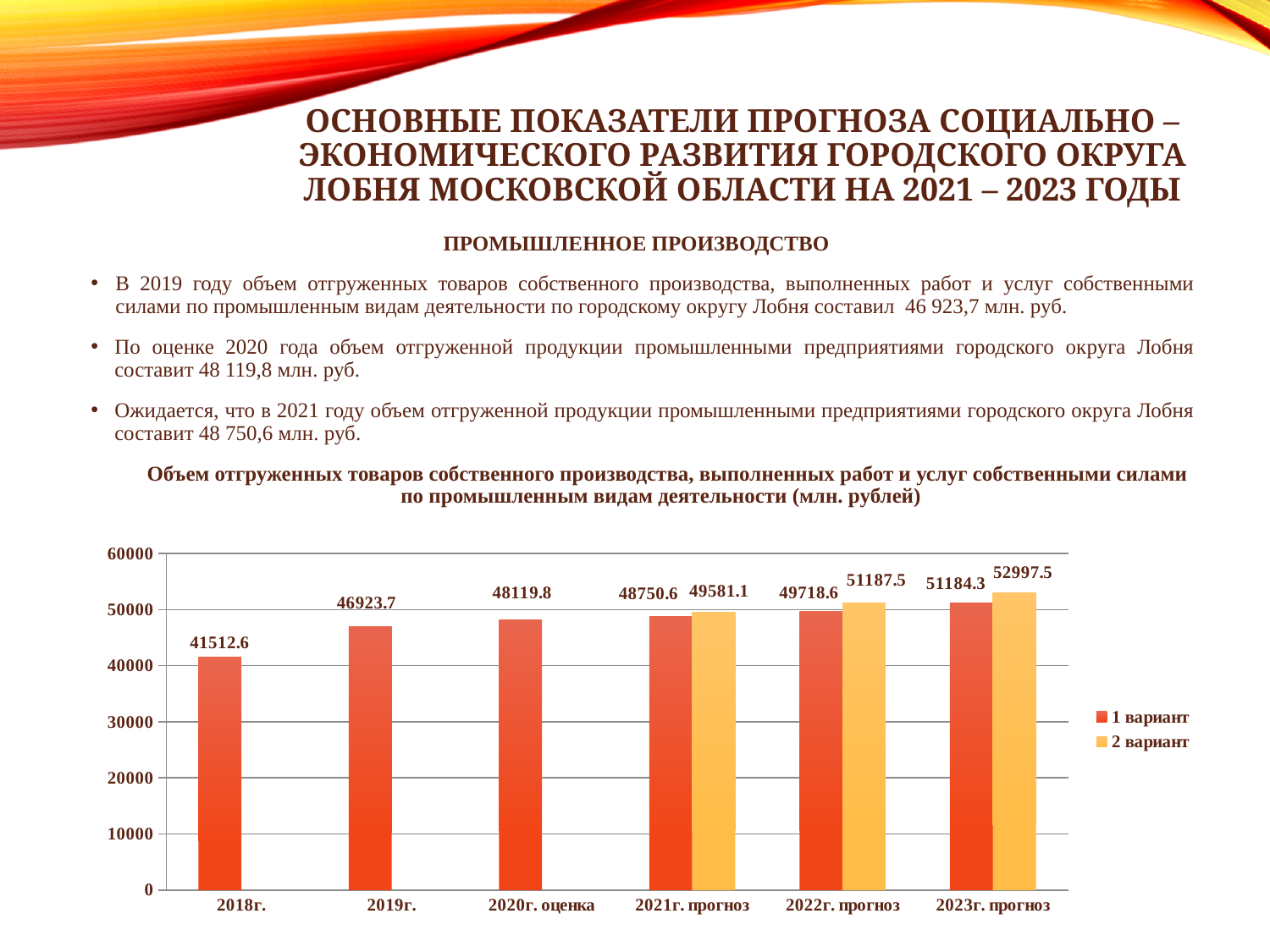
What type of chart is shown on the slide? bar chart How many categories are shown on the x axis? 6 Which is larger in 2021г. прогноз: 1 вариант or 2 вариант? 2 вариант What is the value for 1 вариант in 2018г.? 41512.6 What is the value for 2 вариант in 2023г. прогноз? 52997.5 Which category has the lowest value for 1 вариант? 2018г. How many series does the legend list? 2 Do the 1 вариант values rise or fall from 2018г. to 2023г. прогноз? rise Which category has the highest value for 2 вариант? 2023г. прогноз What is the difference between the 2 вариант and 1 вариант values in 2023г. прогноз? 1813.2 What is the value for 1 вариант in 2020г. оценка? 48119.8 What is the difference between the 1 вариант values for 2019г. and 2018г.? 5411.1